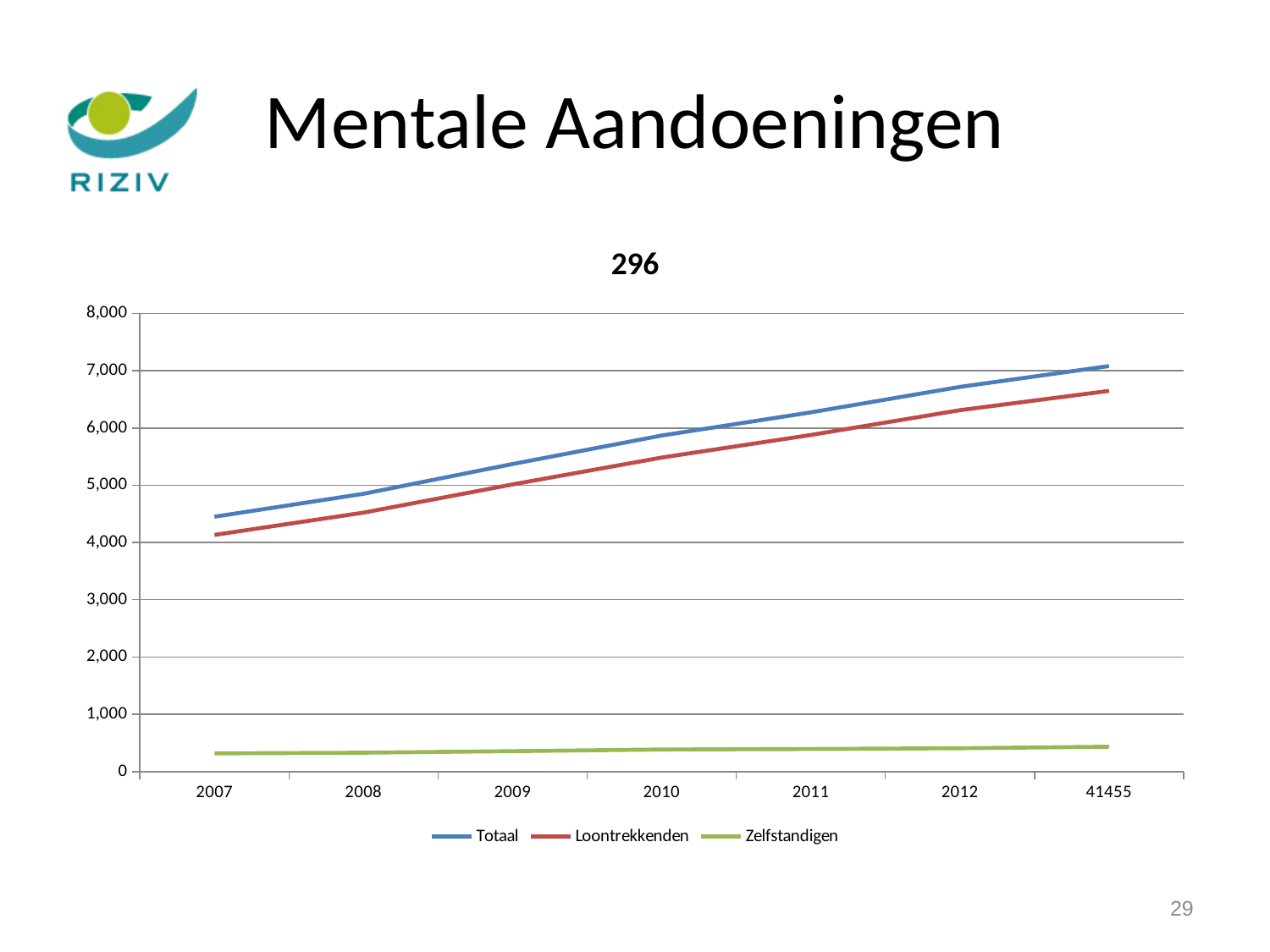
Which series has the highest values across all years? Totaal How many points are plotted along the x axis for each series? 7 Is the value for Zelfstandigen in 2011 greater or less than 1,000? less What kind of chart is shown on the slide? line chart Which series is drawn in green in the legend? Zelfstandigen In 2010, which is larger: the value for Loontrekkenden or the value for Zelfstandigen? Loontrekkenden Does the Totaal series rise or fall from 2007 to the last point? rise What is the title of the chart? 296 Is the value for Loontrekkenden in 2012 greater or less than 6,000? greater Which series has the lowest values across all years? Zelfstandigen How many series does the legend list? 3 Is the value for Totaal in 2007 greater or less than 4,000? greater